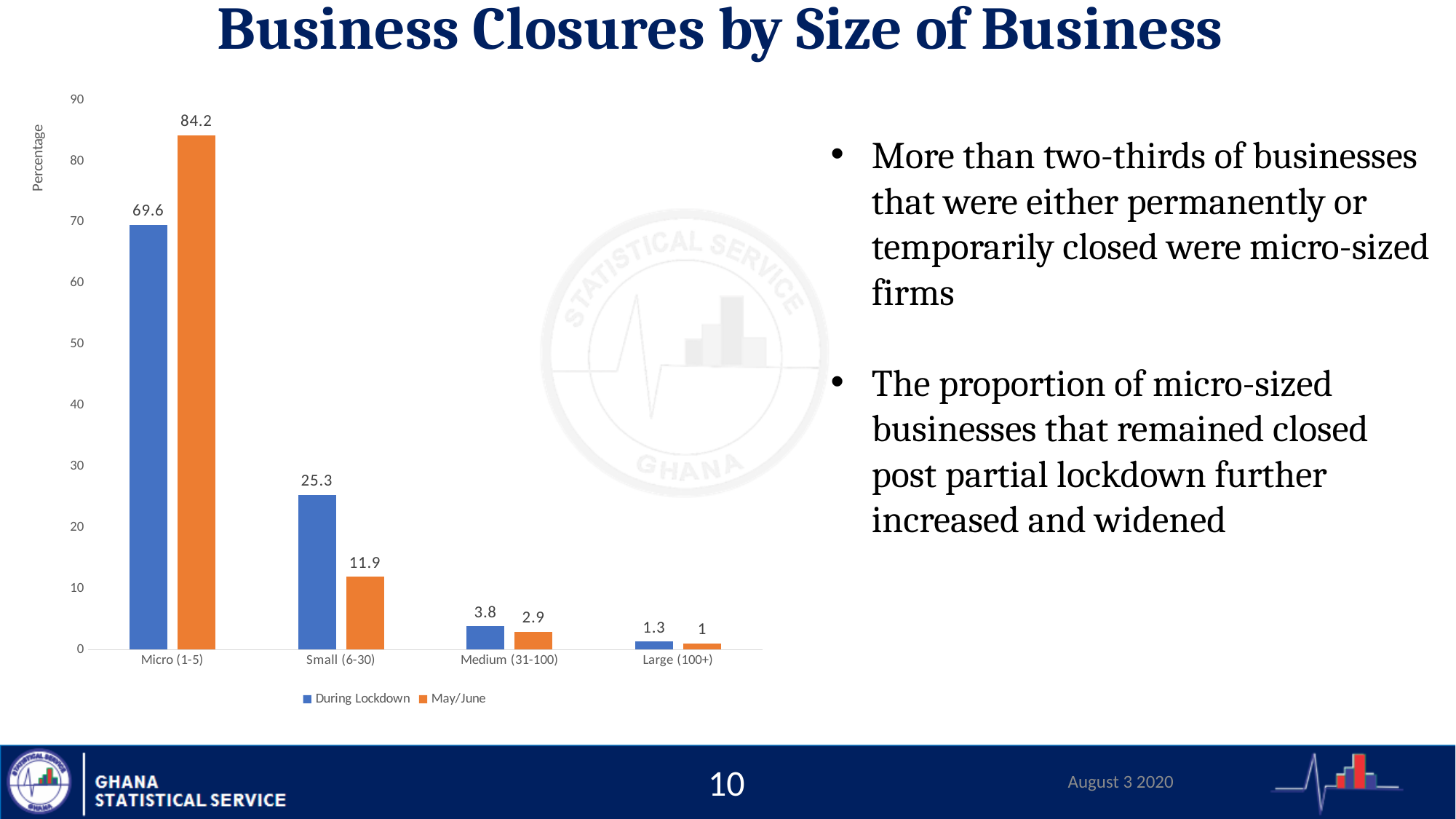
Which business size has the highest May/June value? Micro (1-5) What is the May/June value for Small (6-30)? 11.9 What is the During Lockdown value for Micro (1-5)? 69.6 What is the difference between the May/June and During Lockdown values for Micro (1-5)? 14.6 What kind of chart is shown on the slide? Bar chart What is the May/June value for Large (100+)? 1 How many business size categories are shown on the x axis? 4 Which is larger for Small (6-30): the During Lockdown value or the May/June value? During Lockdown What is the During Lockdown value for Medium (31-100)? 3.8 What is the label of the vertical axis? Percentage Which business size has the lowest During Lockdown value? Large (100+) How many series does the legend list? 2